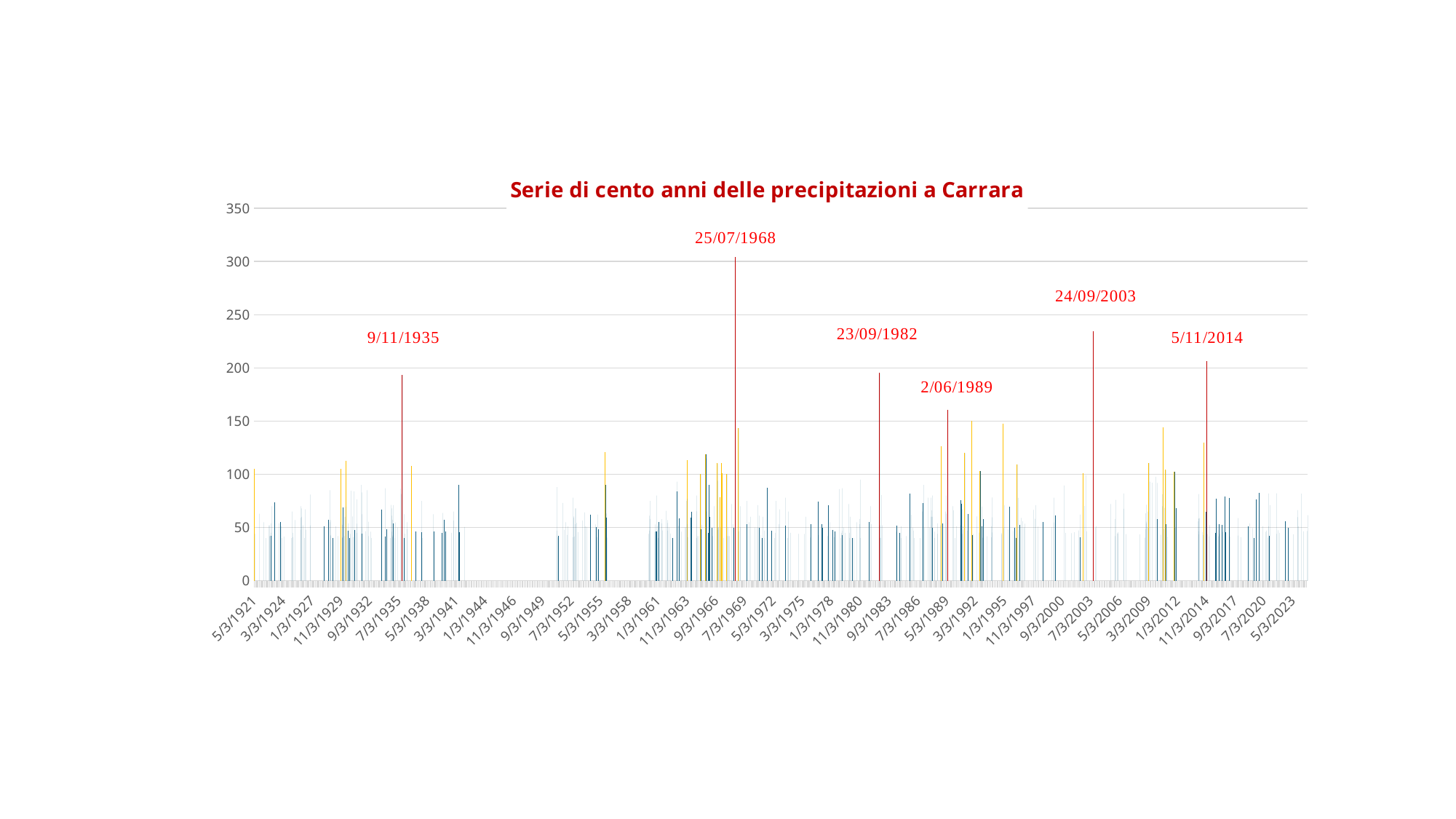
Which is larger, the value for 25/07/1968 or the value for 24/09/2003? 25/07/1968 What is the title of the chart? Serie di cento anni delle precipitazioni a Carrara What kind of chart is shown on the slide? bar chart Is the value for 24/09/2003 greater or less than 250? less Which is larger, the value for 24/09/2003 or the value for 2/06/1989? 24/09/2003 Is the value for 24/09/2003 greater or less than 200? greater Is the value for 2/06/1989 greater or less than 200? less How many dates are annotated with red labels on the chart? 6 Among the six annotated dates, which one has the lowest precipitation value? 2/06/1989 Which annotated date has the highest precipitation value in the chart? 25/07/1968